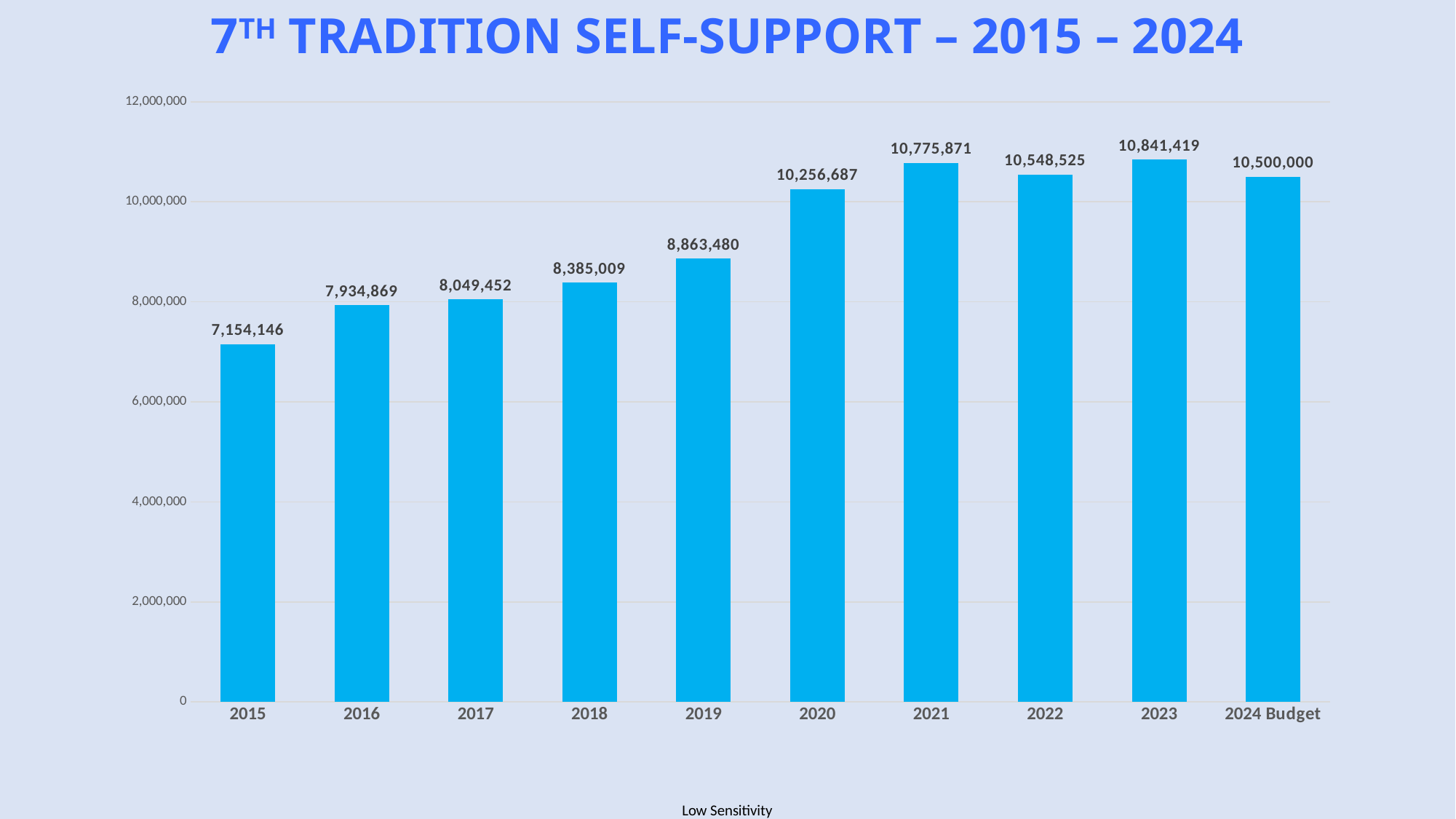
Which year has the lowest value? 2015 Is the value for 2019 greater or less than 10,000,000? less What is the title of the chart? 7TH TRADITION SELF-SUPPORT – 2015 – 2024 What is the difference between the values for 2023 and 2015? 3,687,273 How many bars are shown in the chart? 10 What is the value for 2015? 7,154,146 What is the value for 2024 Budget? 10,500,000 What is the difference between the values for 2021 and 2020? 519,184 Which is larger, the value for 2021 or the value for 2022? 2021 What kind of chart is shown on the slide? bar chart Which year has the highest value? 2023 What is the value for 2020? 10,256,687